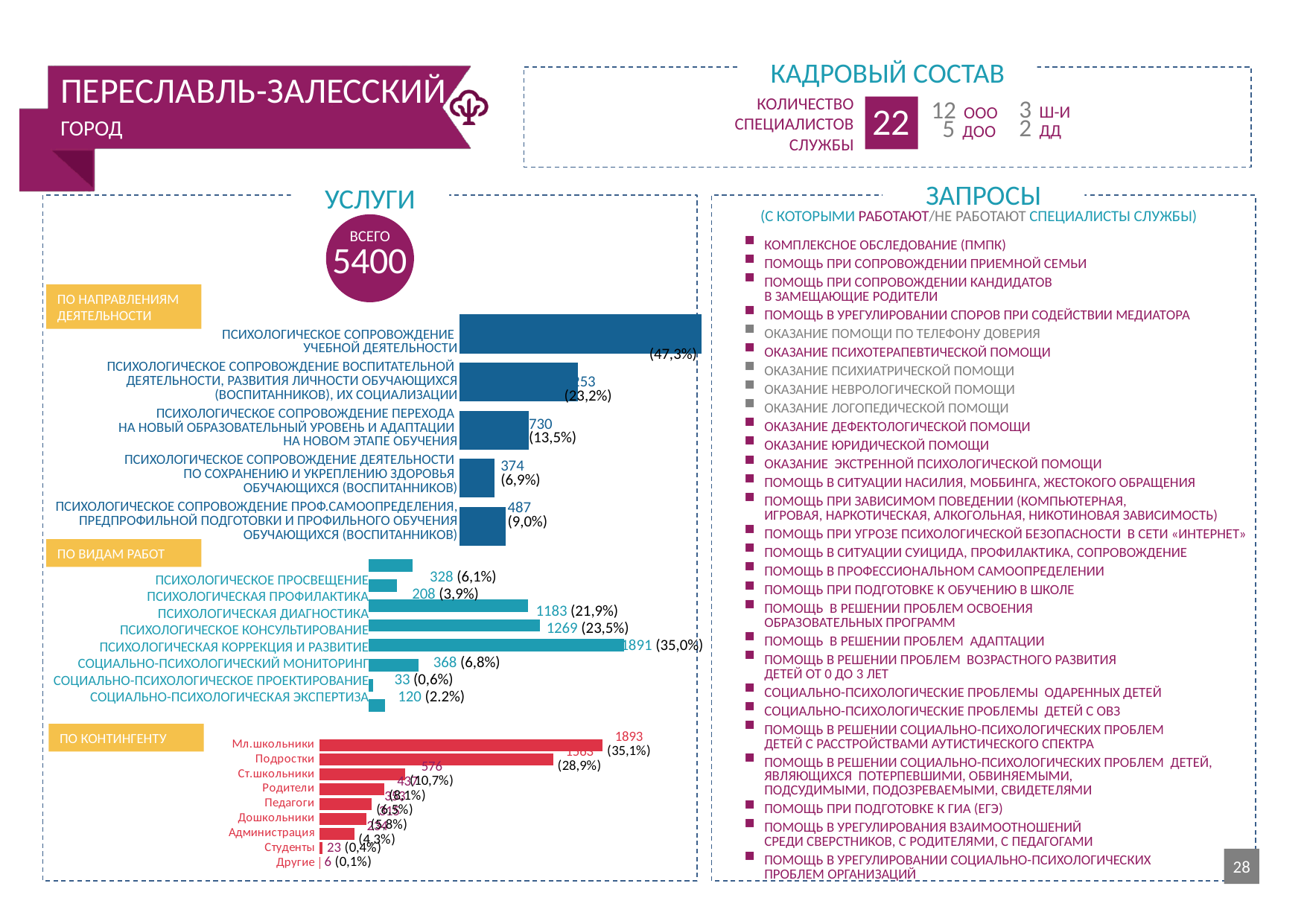
What type of chart is the 'ПО КОНТИНГЕНТУ' chart? Bar chart In the 'ПО НАПРАВЛЕНИЯМ ДЕЯТЕЛЬНОСТИ' chart, what is the value for ПСИХОЛОГИЧЕСКОЕ СОПРОВОЖДЕНИЕ ПЕРЕХОДА НА НОВЫЙ ОБРАЗОВАТЕЛЬНЫЙ УРОВЕНЬ И АДАПТАЦИИ НА НОВОМ ЭТАПЕ ОБУЧЕНИЯ? 730 (13,5%) In the 'ПО ВИДАМ РАБОТ' chart, what is the difference between ПСИХОЛОГИЧЕСКОЕ КОНСУЛЬТИРОВАНИЕ and ПСИХОЛОГИЧЕСКАЯ ДИАГНОСТИКА? 86 In the 'ПО ВИДАМ РАБОТ' chart, which category has the lowest value? СОЦИАЛЬНО-ПСИХОЛОГИЧЕСКОЕ ПРОЕКТИРОВАНИЕ In the 'ПО КОНТИНГЕНТУ' chart, which category has the lowest value? Другие How many categories are shown in the 'ПО ВИДАМ РАБОТ' chart? 8 In the 'ПО ВИДАМ РАБОТ' chart, what is the value for ПСИХОЛОГИЧЕСКАЯ КОРРЕКЦИЯ И РАЗВИТИЕ? 1891 (35,0%) In the 'ПО ВИДАМ РАБОТ' chart, which is larger: ПСИХОЛОГИЧЕСКОЕ ПРОСВЕЩЕНИЕ or ПСИХОЛОГИЧЕСКАЯ ПРОФИЛАКТИКА? ПСИХОЛОГИЧЕСКОЕ ПРОСВЕЩЕНИЕ In the 'ПО КОНТИНГЕНТУ' chart, what is the value for Мл.школьники? 1893 (35,1%) In the 'ПО ВИДАМ РАБОТ' chart, which category has the highest value? ПСИХОЛОГИЧЕСКАЯ КОРРЕКЦИЯ И РАЗВИТИЕ In the 'ПО НАПРАВЛЕНИЯМ ДЕЯТЕЛЬНОСТИ' chart, what is the value for ПСИХОЛОГИЧЕСКОЕ СОПРОВОЖДЕНИЕ ДЕЯТЕЛЬНОСТИ ПО СОХРАНЕНИЮ И УКРЕПЛЕНИЮ ЗДОРОВЬЯ ОБУЧАЮЩИХСЯ (ВОСПИТАННИКОВ)? 374 (6,9%) In the 'ПО ВИДАМ РАБОТ' chart, what is the value for ПСИХОЛОГИЧЕСКОЕ КОНСУЛЬТИРОВАНИЕ? 1269 (23,5%)